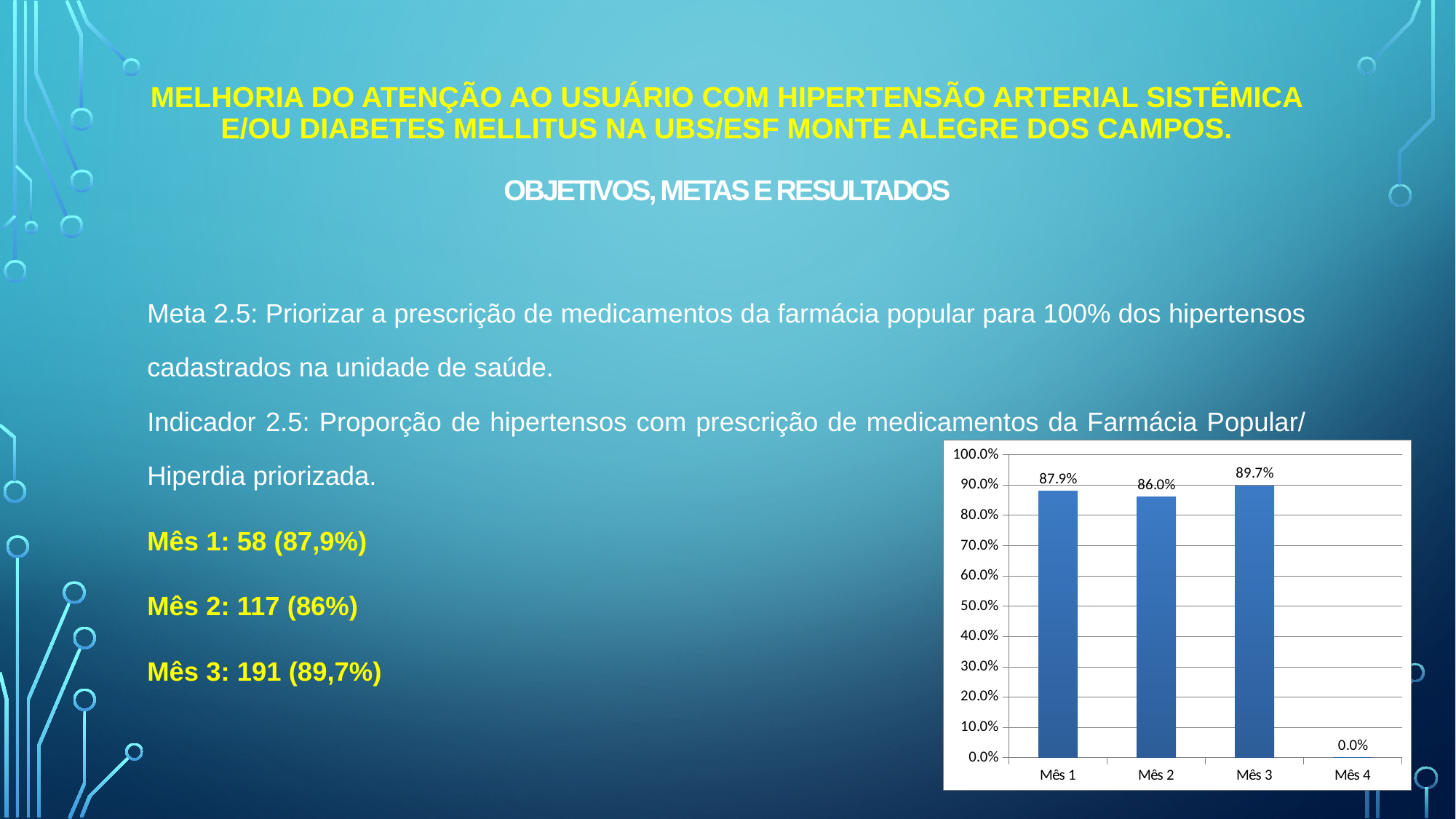
What is the value for Mês 2 in the chart? 86.0% Which month has the highest value in the chart? Mês 3 What is the difference between the values for Mês 3 and Mês 2? 3.7% Is the value for Mês 2 greater or less than 80.0%? greater What is the difference between the values for Mês 1 and Mês 2? 1.9% What is the value for Mês 3 in the chart? 89.7% What is the value for Mês 4 in the chart? 0.0% Which is larger, the value for Mês 1 or the value for Mês 2? Mês 1 What kind of chart is shown on the slide? Bar chart How many months are shown on the x axis of the chart? 4 Which month has the lowest value in the chart? Mês 4 What is the value for Mês 1 in the chart? 87.9%